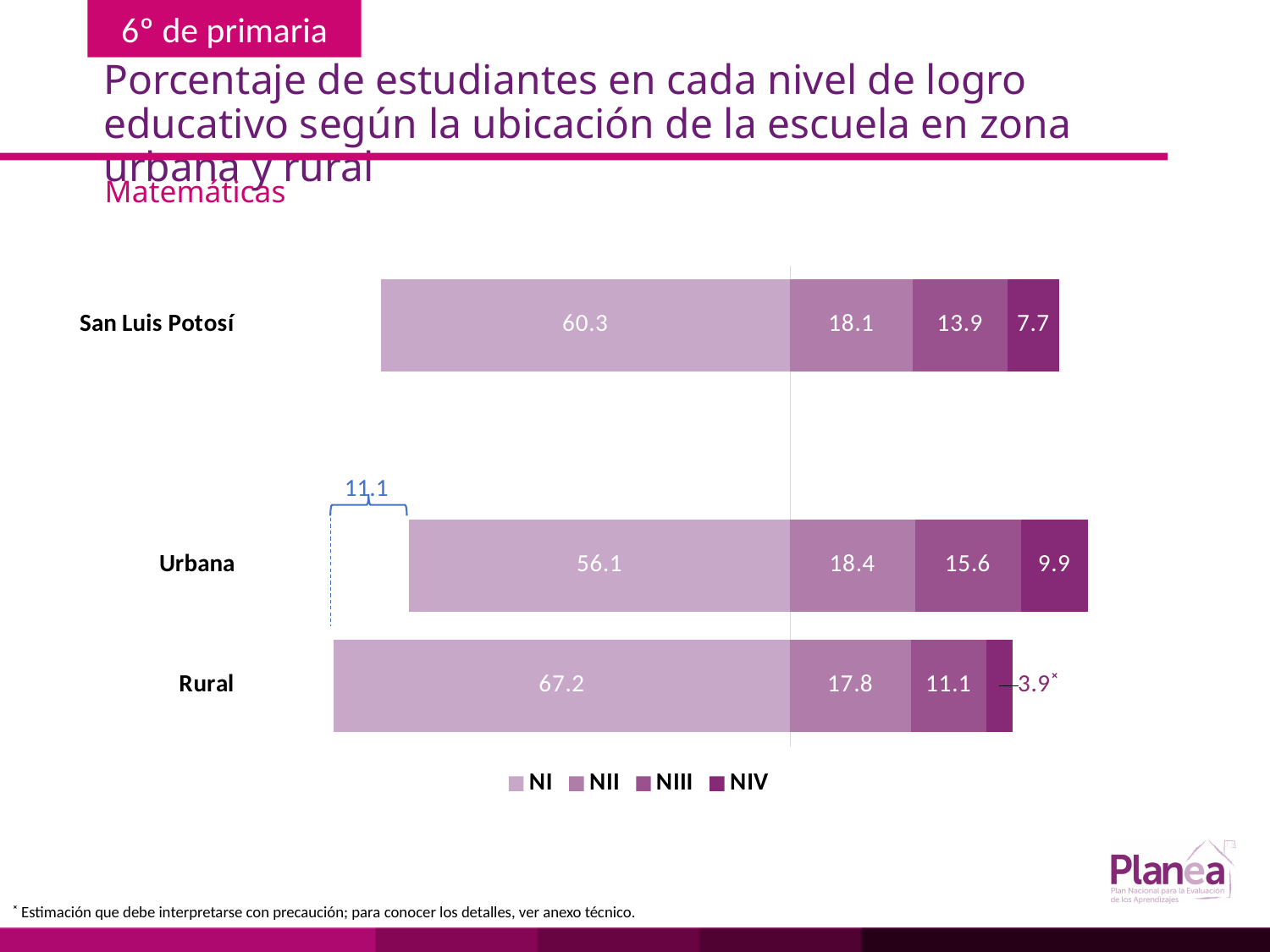
What is the NII value for Rural? 17.8 How many categories (bars) are plotted in the chart? 3 How many series does the legend list? 4 What is the difference between the NI values for Rural and Urbana? 11.1 What kind of chart is shown on the slide? Stacked bar chart Which category has the lowest NIV value? Rural Which series is shown in the darkest purple colour in the legend? NIV What is the NIII value for Urbana? 15.6 What is the NI value for San Luis Potosí? 60.3 What is the NIV value for Urbana? 9.9 Which is larger, the NIII value for San Luis Potosí or the NIII value for Urbana? Urbana Which category has the highest NI value? Rural